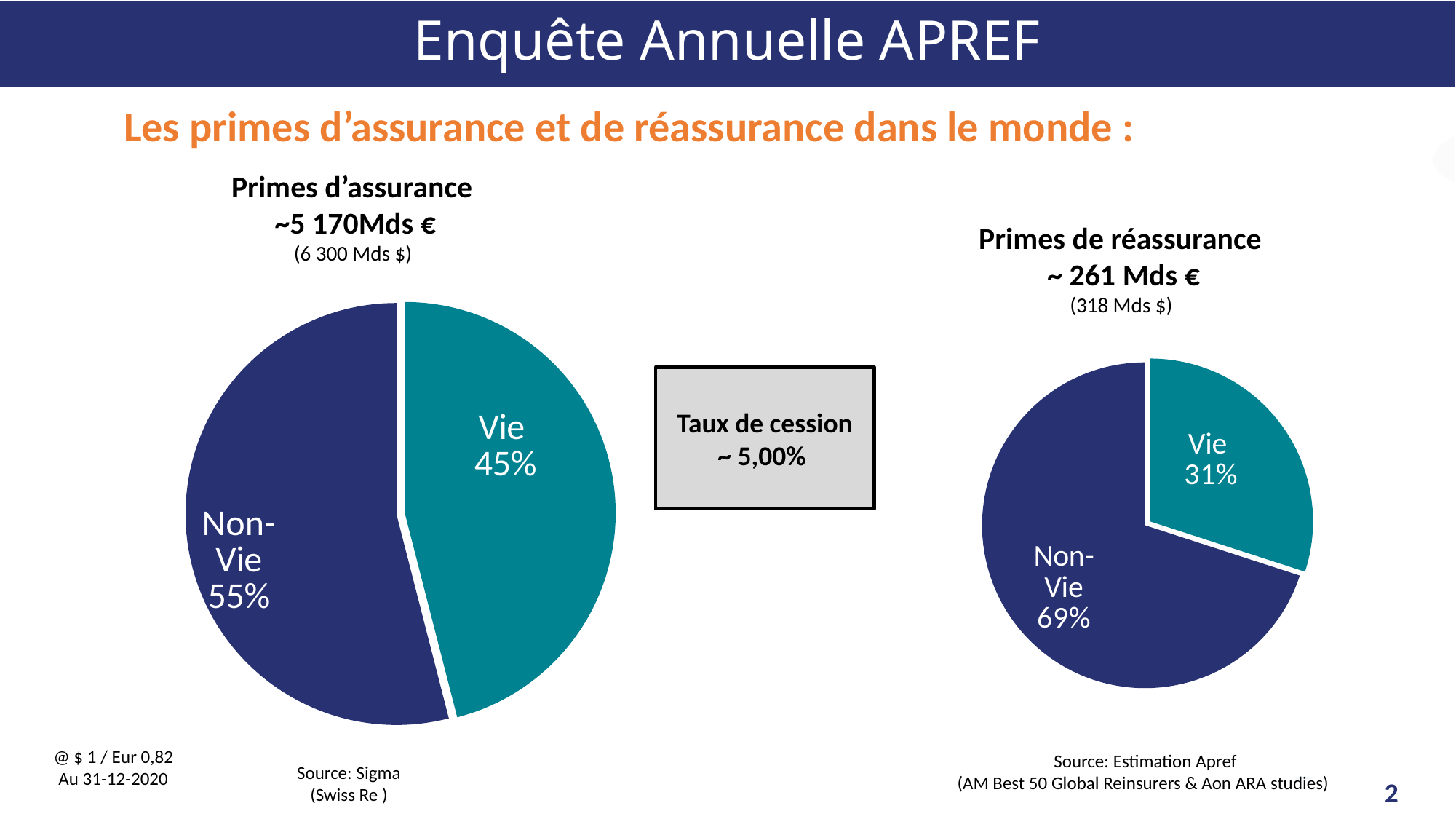
In the 'Primes d'assurance' pie chart, which slice is the largest? Non-Vie In the 'Primes de réassurance' pie chart, what share does Vie have? 31% In the 'Primes de réassurance' pie chart, what is the difference between the Non-Vie and Vie shares? 38% In the 'Primes de réassurance' pie chart, what share does Non-Vie have? 69% How many slices does the 'Primes de réassurance' pie chart have? 2 What type of chart is used for 'Primes d'assurance'? Pie chart In the 'Primes d'assurance' pie chart, what share does Vie have? 45% In the 'Primes d'assurance' pie chart, what share does Non-Vie have? 55% What colour is the Vie slice in the 'Primes d'assurance' pie chart? Teal In the 'Primes de réassurance' pie chart, which slice is the smallest? Vie In the 'Primes d'assurance' pie chart, what is the difference between the Non-Vie and Vie shares? 10% Which is larger: the Vie share in the 'Primes d'assurance' chart or the Vie share in the 'Primes de réassurance' chart? Primes d'assurance